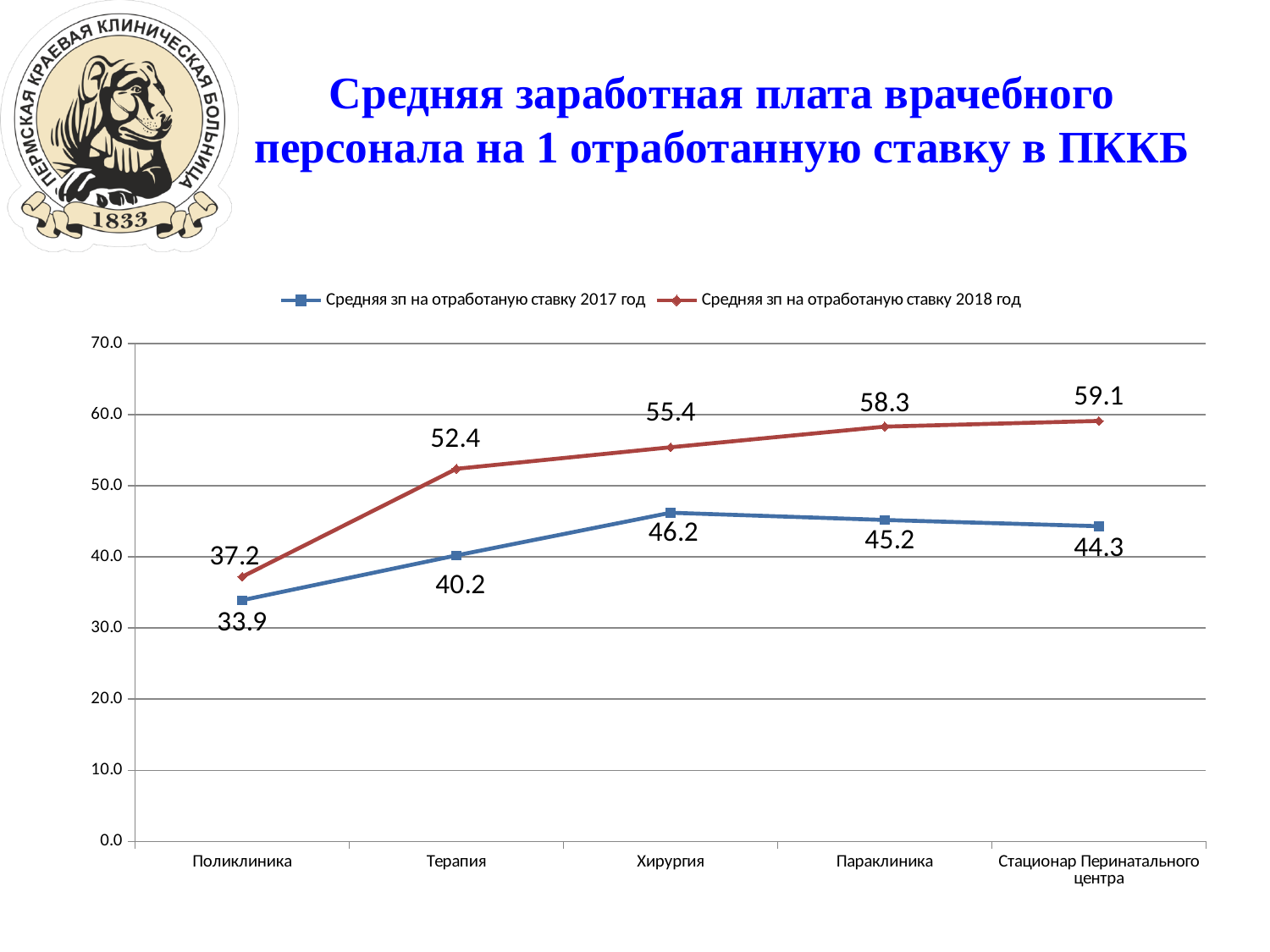
Does the 2018 series rise or fall from Поликлиника to Стационар Перинатального центра? rise Which is larger for Терапия: the 2017 value or the 2018 value? 2018 value (52.4) How many series does the legend list? 2 What is the value for Хирургия in the 2018 series (Средняя зп на отработаную ставку 2018 год)? 55.4 What is the value for Поликлиника in the 2017 series (Средняя зп на отработаную ставку 2017 год)? 33.9 How many categories are shown on the x axis? 5 What is the difference between the 2018 and 2017 values for Параклиника? 13.1 Is the 2017 value for Хирургия greater or less than 50.0? less What kind of chart is shown on the slide? line chart What colour is the line for the 2017 series? blue Which category has the lowest value in the 2017 series? Поликлиника Which category has the highest value in the 2018 series? Стационар Перинатального центра